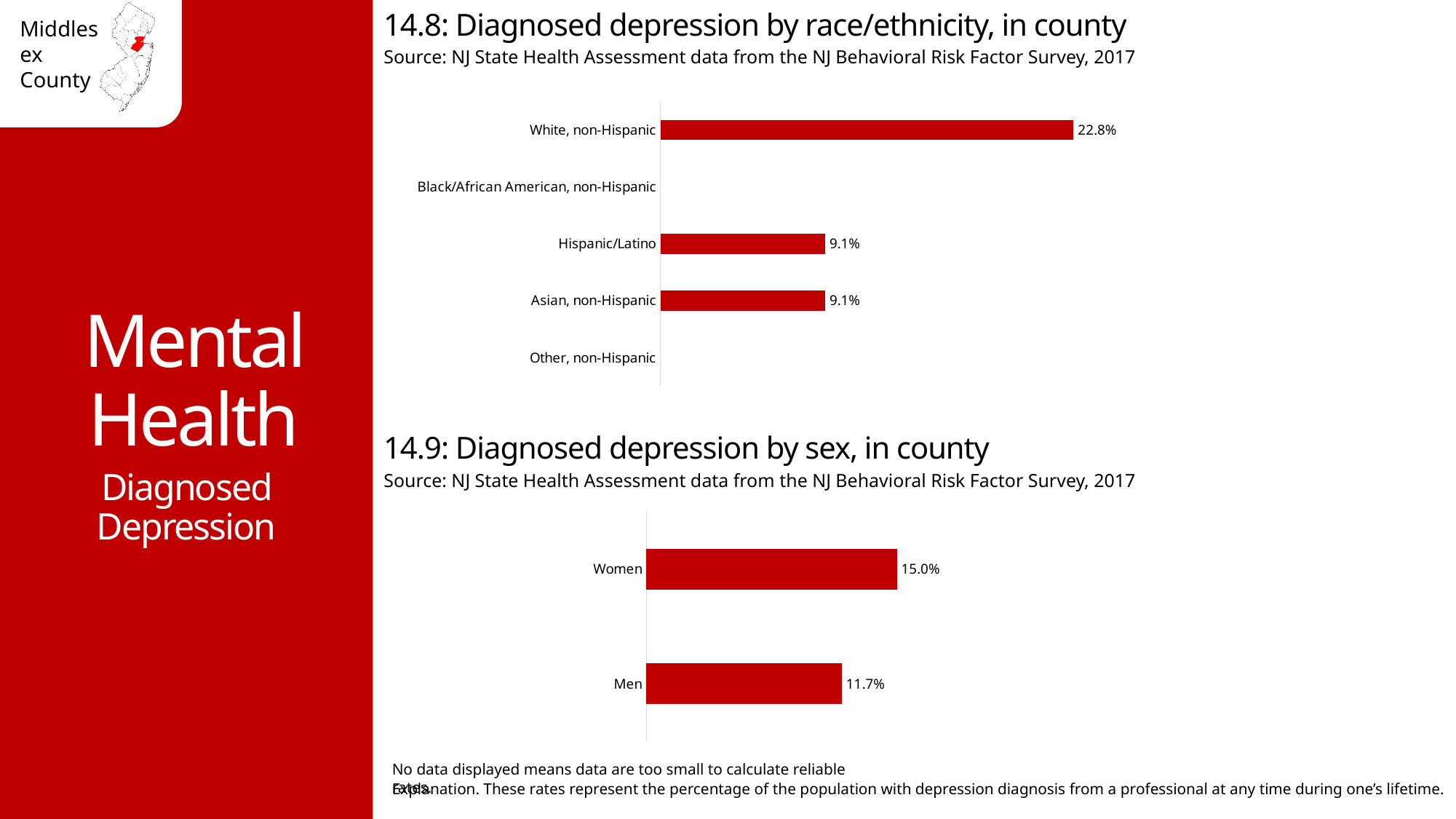
In the chart '14.9: Diagnosed depression by sex, in county', which is larger, the value for Women or the value for Men? Women In the chart '14.8: Diagnosed depression by race/ethnicity, in county', which category has the highest value? White, non-Hispanic In the chart '14.8: Diagnosed depression by race/ethnicity, in county', what is the value for Hispanic/Latino? 9.1% In the chart '14.8: Diagnosed depression by race/ethnicity, in county', what is the value for Asian, non-Hispanic? 9.1% In the chart '14.9: Diagnosed depression by sex, in county', what is the difference between the values for Women and Men? 3.3% In the chart '14.8: Diagnosed depression by race/ethnicity, in county', how many categories are listed on the axis? 5 In the chart '14.8: Diagnosed depression by race/ethnicity, in county', what is the difference between the values for White, non-Hispanic and Hispanic/Latino? 13.7% What kind of chart is '14.9: Diagnosed depression by sex, in county'? Bar chart In the chart '14.9: Diagnosed depression by sex, in county', what is the value for Men? 11.7% In the chart '14.9: Diagnosed depression by sex, in county', what is the value for Women? 15.0% In the chart '14.8: Diagnosed depression by race/ethnicity, in county', what is the value for White, non-Hispanic? 22.8% In the chart '14.8: Diagnosed depression by race/ethnicity, in county', which categories have no bar displayed? Black/African American, non-Hispanic and Other, non-Hispanic